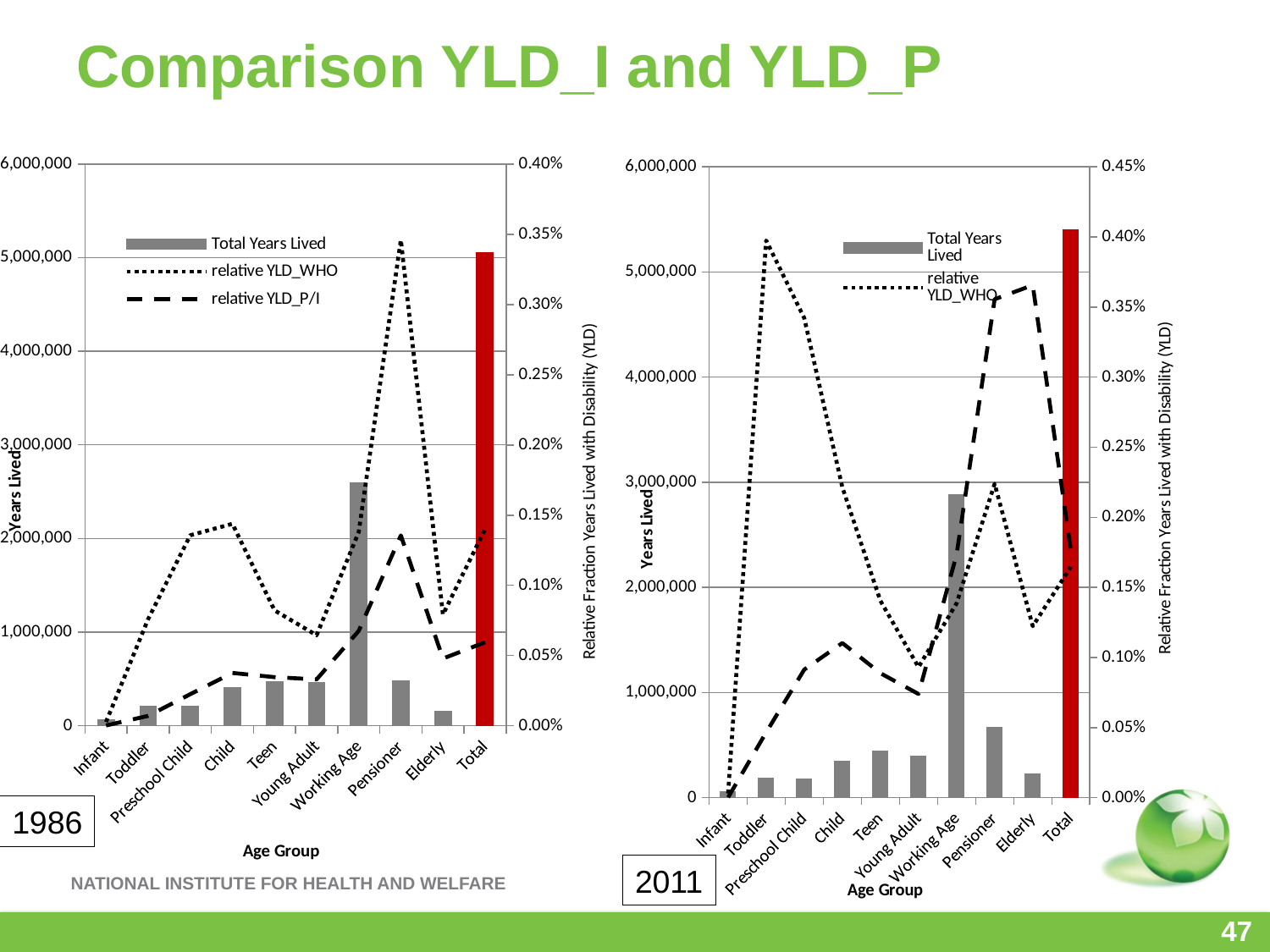
In the 1986 chart, is the Total Years Lived value for Working Age greater or less than 2,000,000? greater In the 1986 chart, which age group has the tallest Total Years Lived bar, excluding the Total bar? Working Age How many categories are shown on the x axis of the 1986 chart? 10 What kind of chart is used to show Total Years Lived in the 2011 chart? bar chart In the 2011 chart, which age group has the shortest Total Years Lived bar? Infant How many series does the legend of the 1986 chart list? 3 What colour is the Total bar in both charts? red In the 1986 chart, does the relative YLD_WHO line rise or fall from Working Age to Pensioner? rise In the 1986 chart, is the Total Years Lived value for Pensioner greater or less than 1,000,000? less In the 2011 chart, is the Total Years Lived value for the Total bar greater or less than 5,000,000? greater In the 1986 chart, which has the larger Total Years Lived bar, Pensioner or Elderly? Pensioner In the 2011 chart, which has the larger Total Years Lived bar, Pensioner or Teen? Pensioner